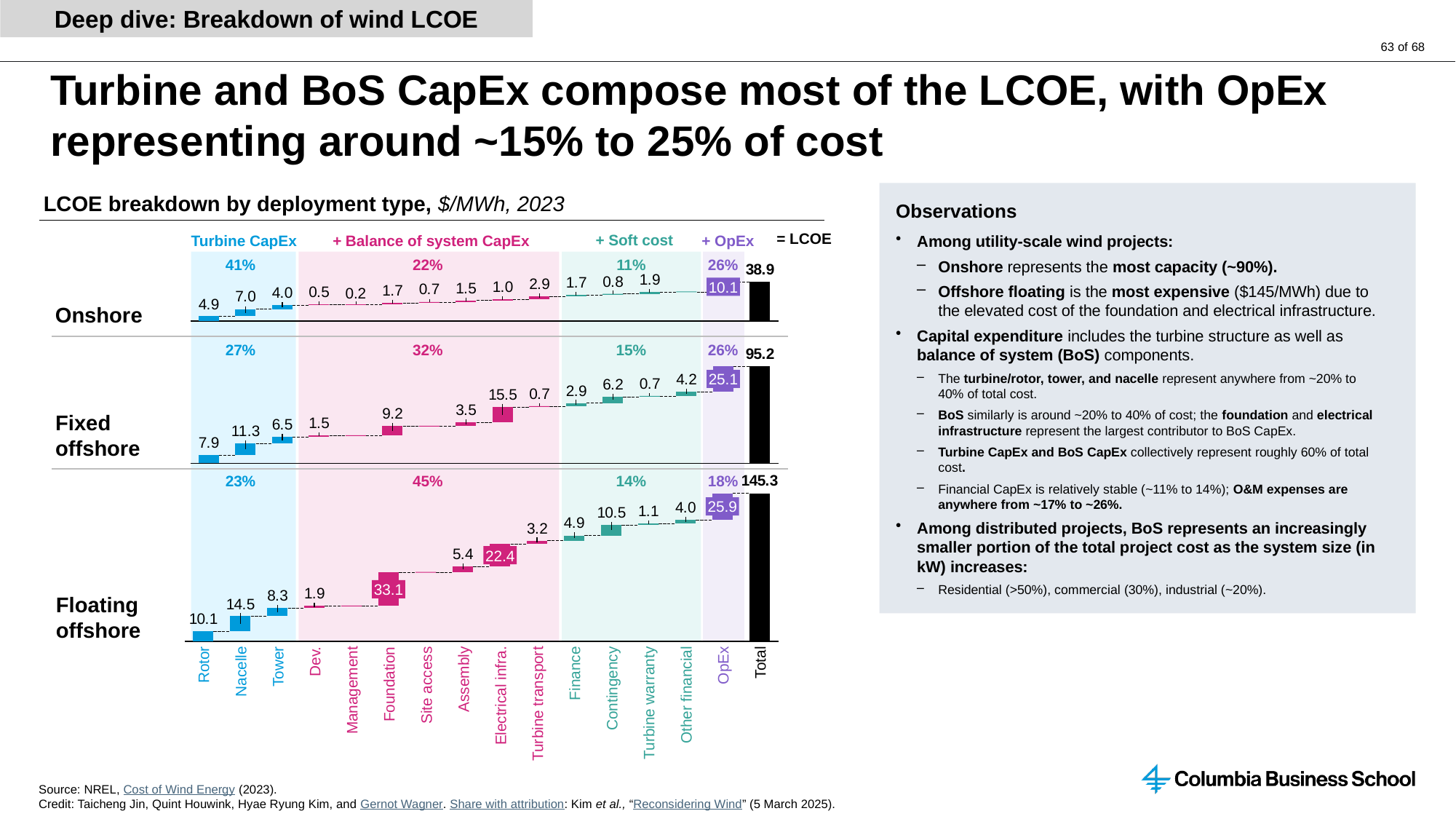
What unit is the LCOE breakdown chart measured in? $/MWh In the Floating offshore chart, what is the value for Foundation? 33.1 In the Floating offshore chart, which is larger: Nacelle or Rotor? Nacelle What is the difference between the Total LCOE for Fixed offshore and Onshore? 56.3 In the Onshore chart, what is the value for OpEx? 10.1 What is the Total LCOE shown for Floating offshore? 145.3 In the Fixed offshore chart, what is the value for Electrical infra.? 15.5 In the Floating offshore chart, which component has the highest value? Foundation What share of the Floating offshore LCOE does Balance of system CapEx represent? 45% What share of the Onshore LCOE does Turbine CapEx represent? 41% In the Fixed offshore chart, which of the three Turbine CapEx components (Rotor, Nacelle, Tower) has the lowest value? Tower How many deployment types are shown in the LCOE breakdown? 3